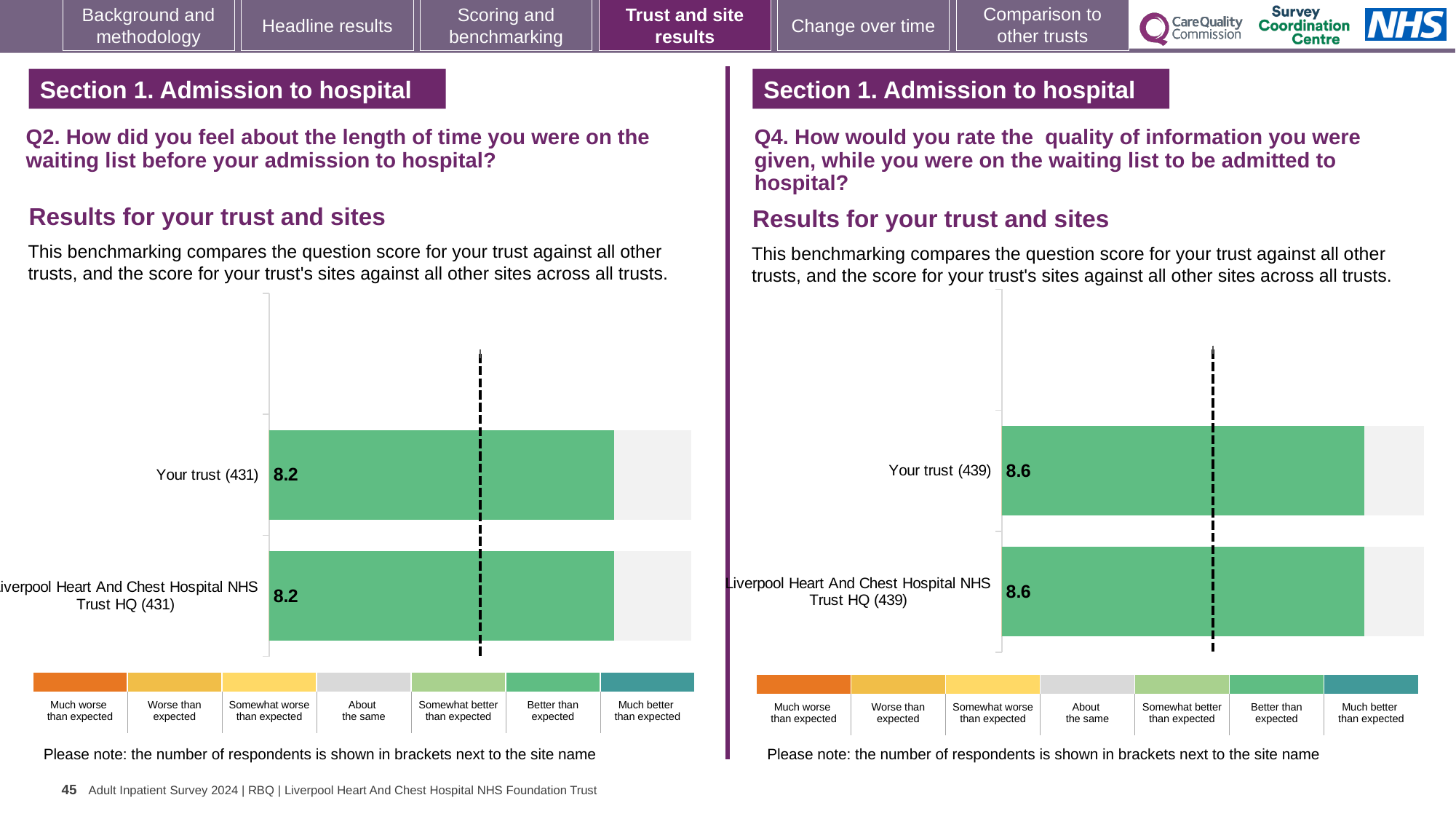
How many bars are plotted in the right chart (Q4)? 2 What kind of chart is used for the Q2 results on the left? Bar chart What is the difference between the Your trust score in the right chart (Q4) and the Your trust score in the left chart (Q2)? 0.4 In the right chart (Q4), what colour are the plotted bars? Green In the left chart (Q2), how many respondents are shown in brackets for Your trust? 431 In the right chart (Q4), what is the score for Liverpool Heart And Chest Hospital NHS Trust HQ (439)? 8.6 In the right chart (Q4), what is the score for Your trust (439)? 8.6 Which is larger: the Your trust score in the left chart (Q2) or the Your trust score in the right chart (Q4)? Right chart (Q4) In the left chart (Q2), what is the score for Liverpool Heart And Chest Hospital NHS Trust HQ (431)? 8.2 How many bars are plotted in the left chart (Q2)? 2 In the left chart (Q2), what is the score for Your trust (431)? 8.2